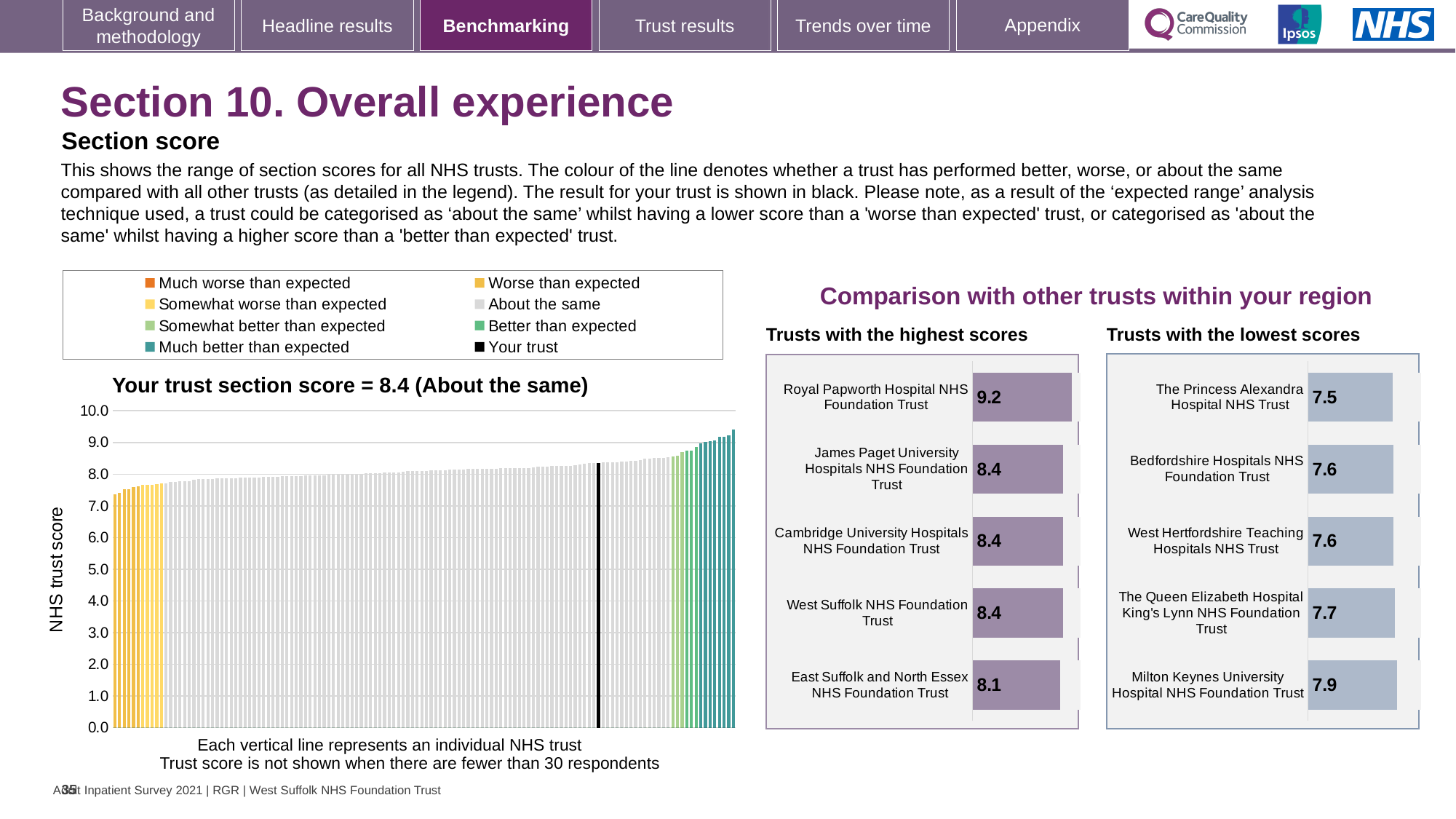
In the 'Trusts with the lowest scores' chart, which has the larger score: Milton Keynes University Hospital NHS Foundation Trust or The Princess Alexandra Hospital NHS Trust? Milton Keynes University Hospital NHS Foundation Trust How many entries does the legend of the left chart list? 8 According to the title of the left chart, what is your trust's section score? 8.4 In the 'Trusts with the highest scores' chart, which trust has the highest score? Royal Papworth Hospital NHS Foundation Trust In the 'Trusts with the lowest scores' chart, what is the score for Milton Keynes University Hospital NHS Foundation Trust? 7.9 In the 'Trusts with the highest scores' chart, what is the score for Royal Papworth Hospital NHS Foundation Trust? 9.2 In the 'Trusts with the highest scores' chart, what is the difference between the scores of Royal Papworth Hospital NHS Foundation Trust and East Suffolk and North Essex NHS Foundation Trust? 1.1 What kind of chart is the 'Your trust section score' chart on the left? Bar chart How many trusts are shown in the 'Trusts with the highest scores' chart? 5 In the 'Trusts with the lowest scores' chart, which trust has the lowest score? The Princess Alexandra Hospital NHS Trust In the left chart, is the value of the lowest-scoring trust greater or less than 7.0? greater In the 'Trusts with the lowest scores' chart, what is the score for The Princess Alexandra Hospital NHS Trust? 7.5